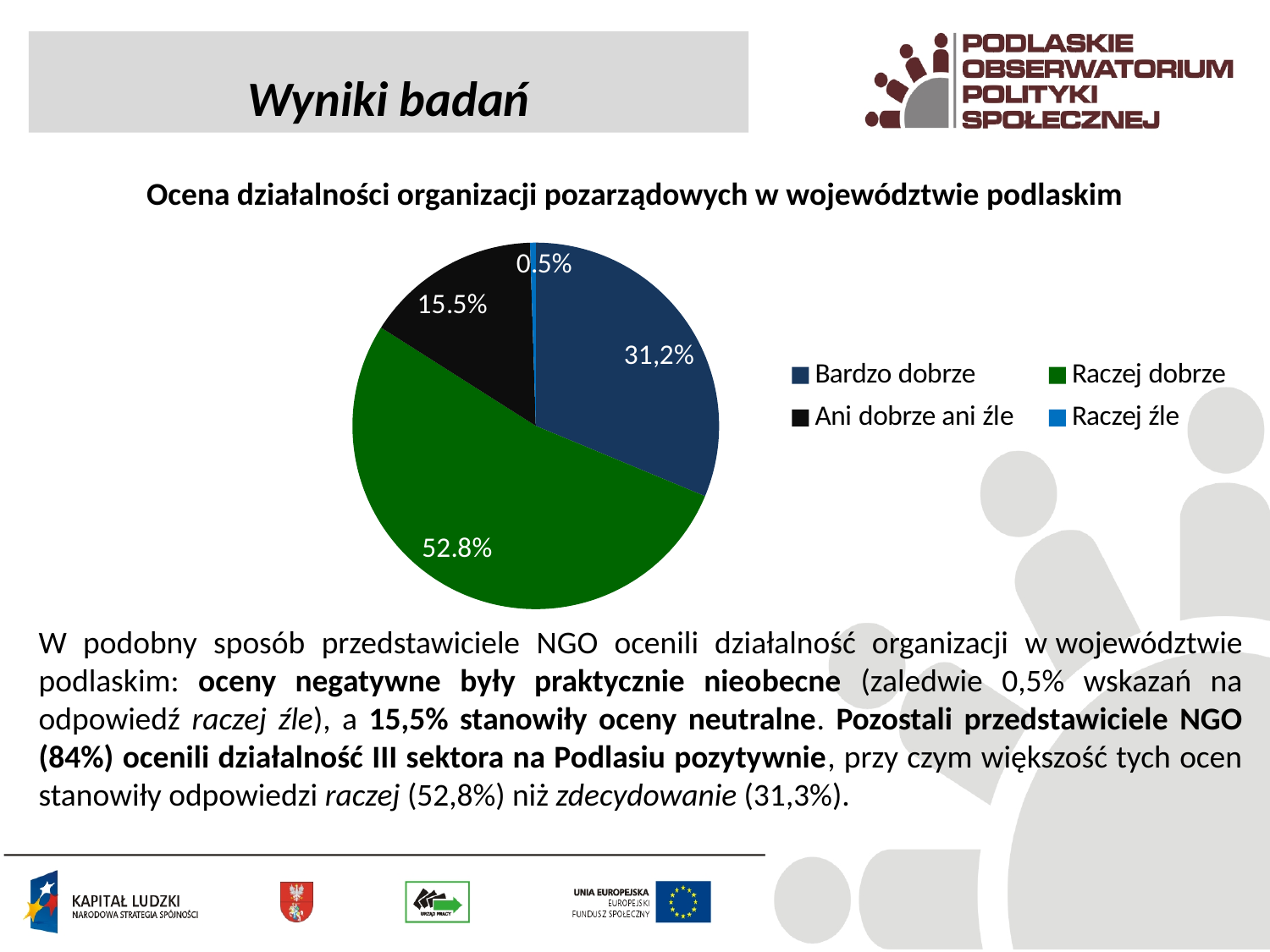
Which category has the smallest slice of the pie? Raczej źle What colour is the slice for "Raczej dobrze"? green What share of the pie is labelled for "Raczej dobrze"? 52.8% How many categories does the legend of the pie chart list? 4 What share of the pie is labelled for "Raczej źle"? 0.5% Which slice is larger: "Bardzo dobrze" or "Ani dobrze ani źle"? Bardzo dobrze What share of the pie is labelled for "Ani dobrze ani źle"? 15.5% What is the title of the chart? Ocena działalności organizacji pozarządowych w województwie podlaskim What kind of chart is shown on the slide? pie chart Which category is represented by the black slice? Ani dobrze ani źle What share of the pie is labelled for "Bardzo dobrze"? 31,2% Which category has the largest slice of the pie? Raczej dobrze